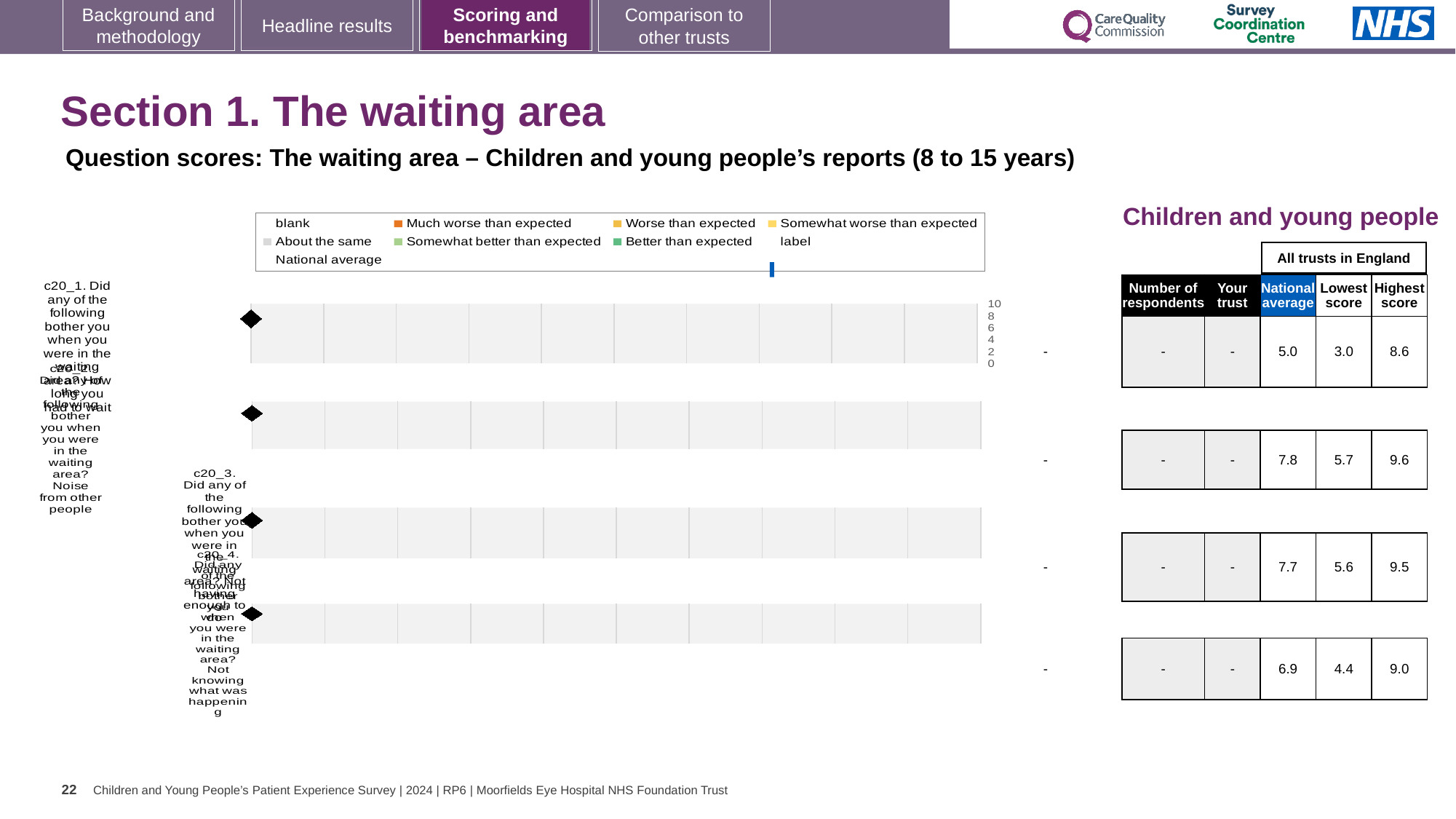
What kind of chart is shown on the slide? bar chart In the table beside the chart, what is the national average for c20_1 (bothered by waiting area)? 5.0 How many survey questions (categories) are plotted in the chart? 4 Which question has the highest national average in the table beside the chart? c20_2 Is the national average for c20_3 in the table larger or smaller than the national average for c20_4? larger In the table beside the chart, what is the lowest score for c20_4 (not knowing what was happening)? 4.4 What value is shown in the 'Your trust' column for c20_1 in the table beside the chart? - What is the highest value shown on the chart's score axis? 10 Which question has the lowest national average in the table beside the chart? c20_1 What is the difference between the highest score and the lowest score for c20_1 in the table beside the chart? 5.6 In the table beside the chart, what is the highest score for c20_2 (how long you had to wait)? 9.6